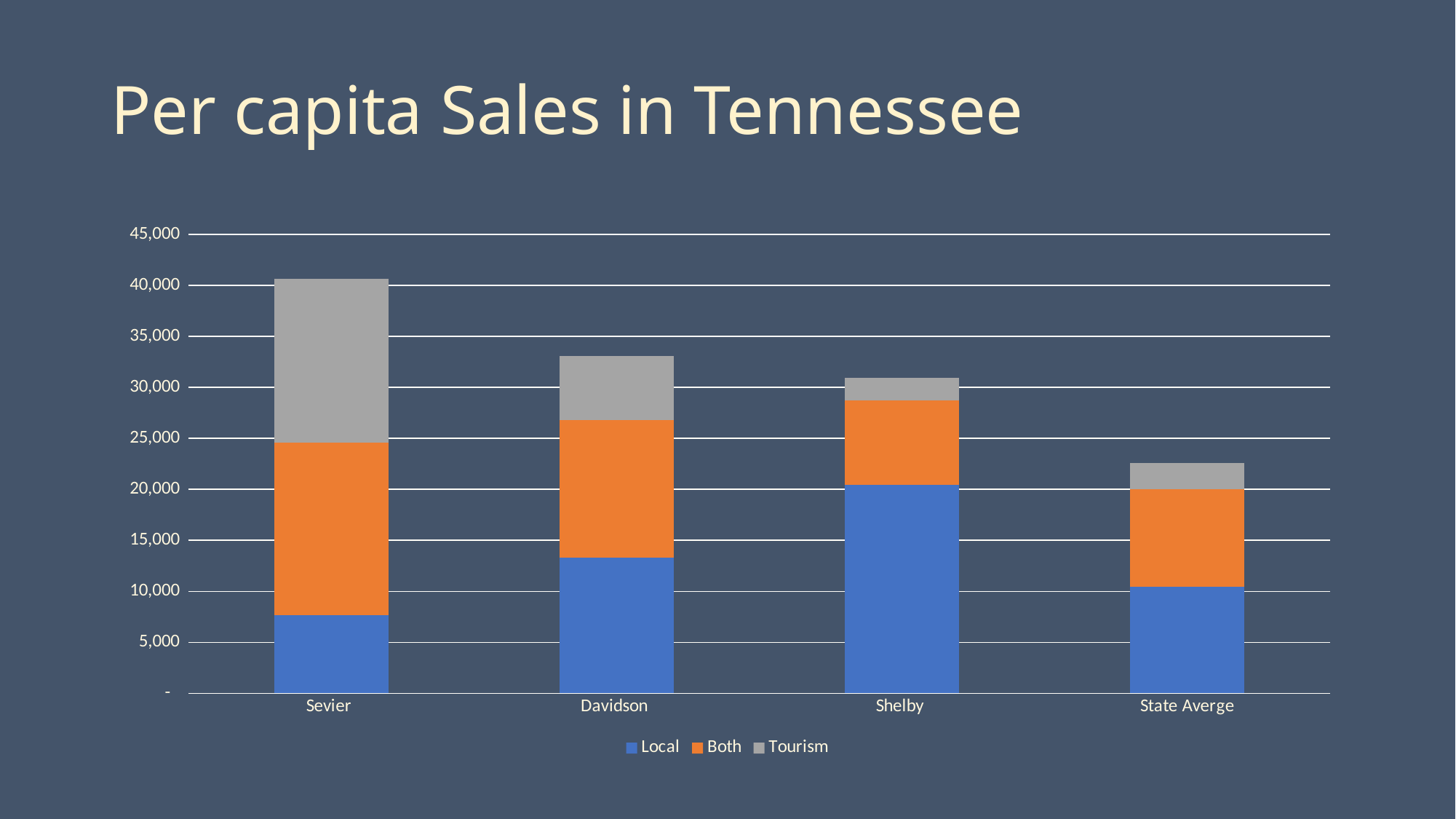
Which category has the highest total per capita sales? Sevier Which has a larger total, Davidson or Shelby? Davidson Is the total for State Averge greater or less than 25,000? less What kind of chart is shown on the slide? Stacked bar chart Is the total for Davidson greater or less than 30,000? greater How many categories are shown along the x axis? 4 How many series does the legend list? 3 Which category has the largest Local segment? Shelby Which category has the largest Tourism segment? Sevier Which category has the smallest Local segment? Sevier Which category has the lowest total per capita sales? State Averge What is the title of the chart? Per capita Sales in Tennessee